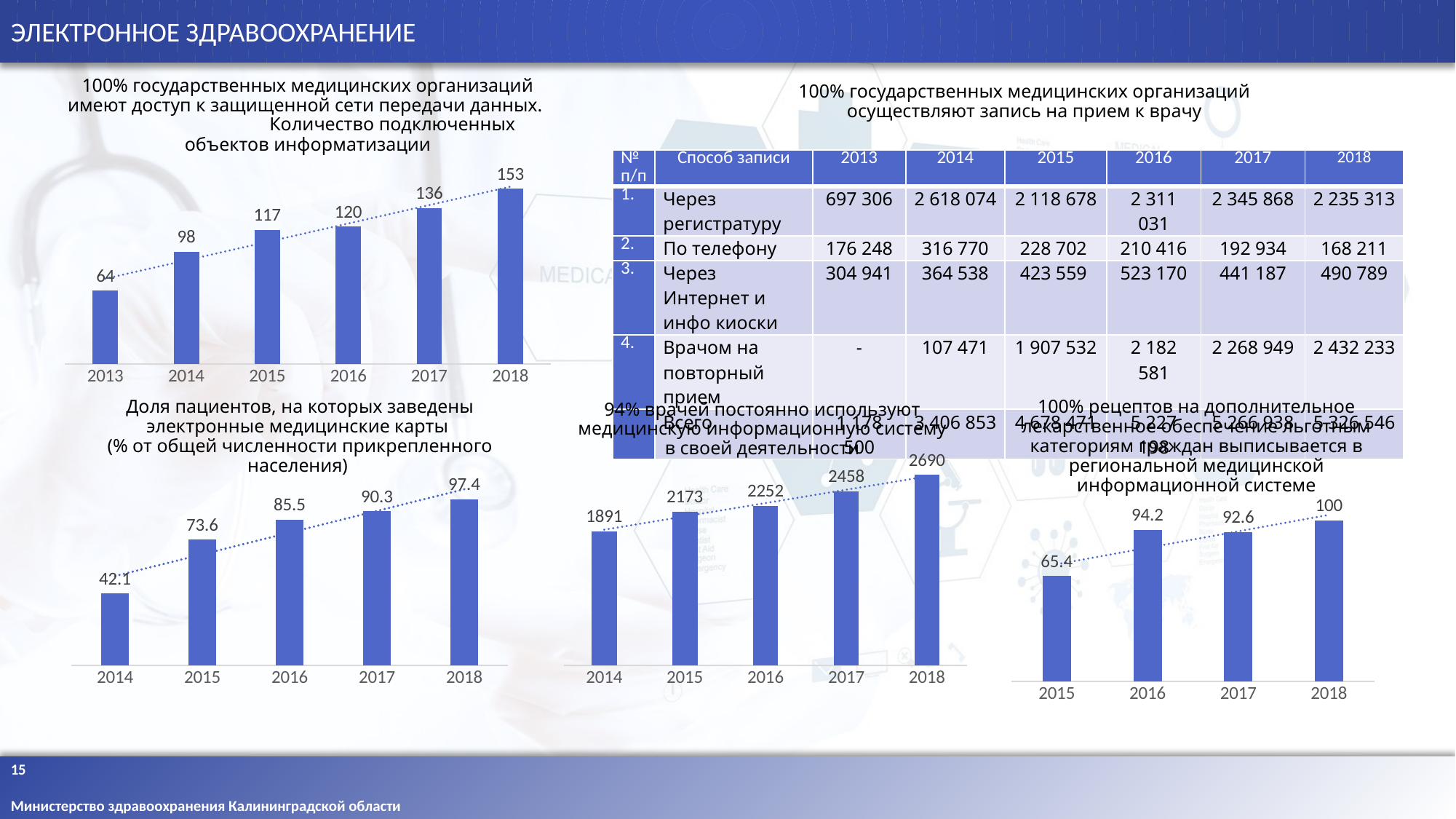
On the bottom-middle chart (94% врачей постоянно используют медицинскую информационную систему), which year has the highest value? 2018 On the bottom-left chart (Доля пациентов, на которых заведены электронные медицинские карты), do the values rise or fall from 2014 to 2018? rise On the top-left chart (Количество подключенных объектов информатизации), how many years are plotted? 6 On the bottom-left chart (Доля пациентов, на которых заведены электронные медицинские карты), what is the difference between the 2015 and 2014 values? 31.5 On the top-left chart (Количество подключенных объектов информатизации), what is the value for 2015? 117 On the top-left chart (Количество подключенных объектов информатизации), what is the difference between the 2018 and 2013 values? 89 On the bottom-middle chart (94% врачей постоянно используют медицинскую информационную систему), what is the value for 2017? 2458 What kind of chart is the bottom-right chart (100% рецептов на дополнительное лекарственное обеспечение)? bar chart On the top-left chart (Количество подключенных объектов информатизации), which year has the lowest value? 2013 On the bottom-right chart (100% рецептов на дополнительное лекарственное обеспечение), what is the value for 2015? 65.4 On the bottom-left chart (Доля пациентов, на которых заведены электронные медицинские карты), what is the value for 2016? 85.5 On the bottom-right chart (100% рецептов на дополнительное лекарственное обеспечение), which is larger, the value for 2016 or 2017? 2016